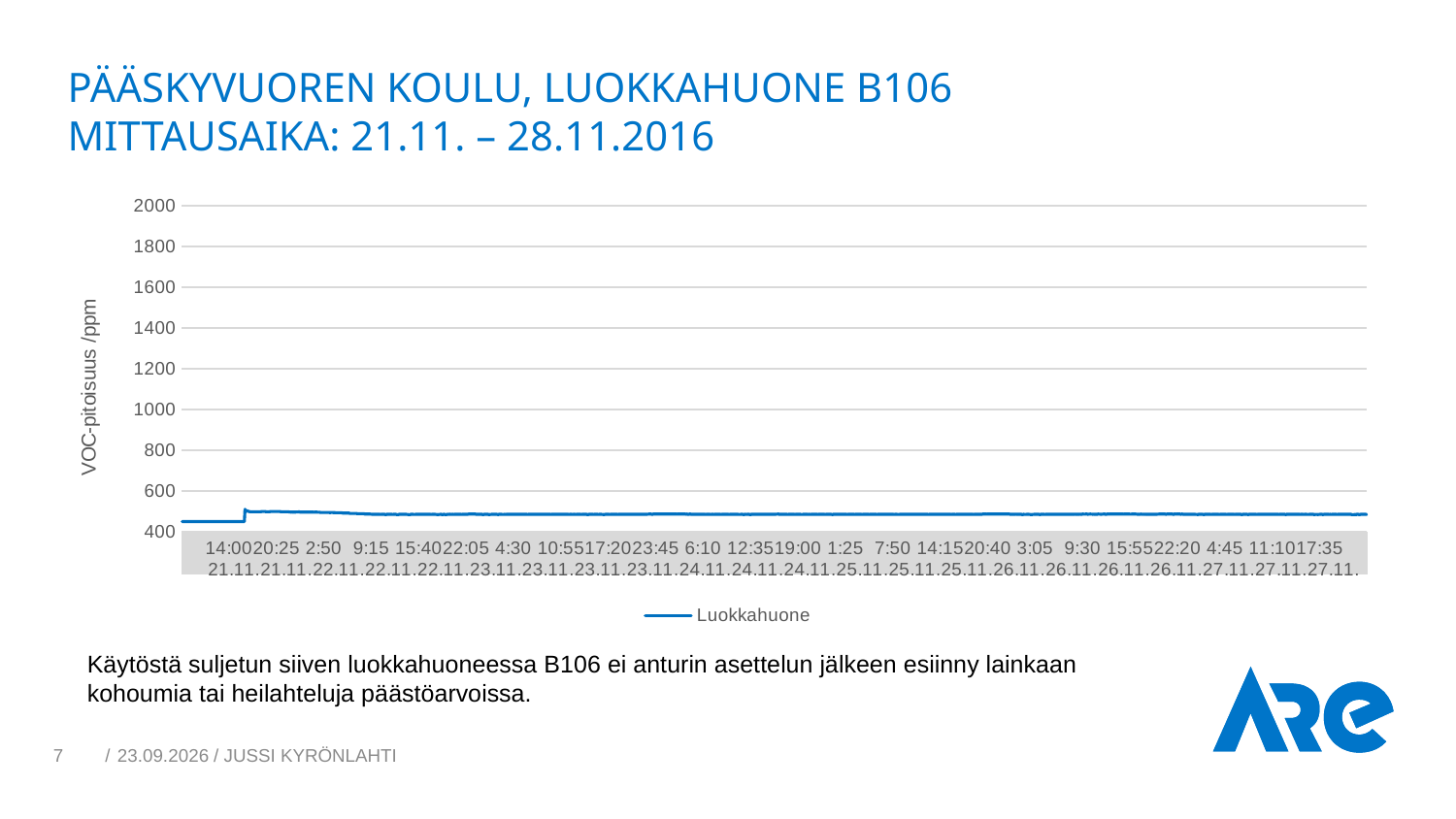
Is the value for Luokkahuone at 17:35 27.11. greater or less than 800? less What is the highest value shown on the y-axis? 2000 What is the label of the y-axis? VOC-pitoisuus /ppm What is the name of the series shown in the legend? Luokkahuone Overall, does the Luokkahuone line rise sharply, fall sharply, or stay roughly flat across the x axis? stays roughly flat What kind of chart is shown on the slide? line chart Is the value for Luokkahuone at 12:35 24.11. greater or less than 1000? less Is the value for Luokkahuone at 14:00 21.11. greater or less than 600? less How many series does the legend list? 1